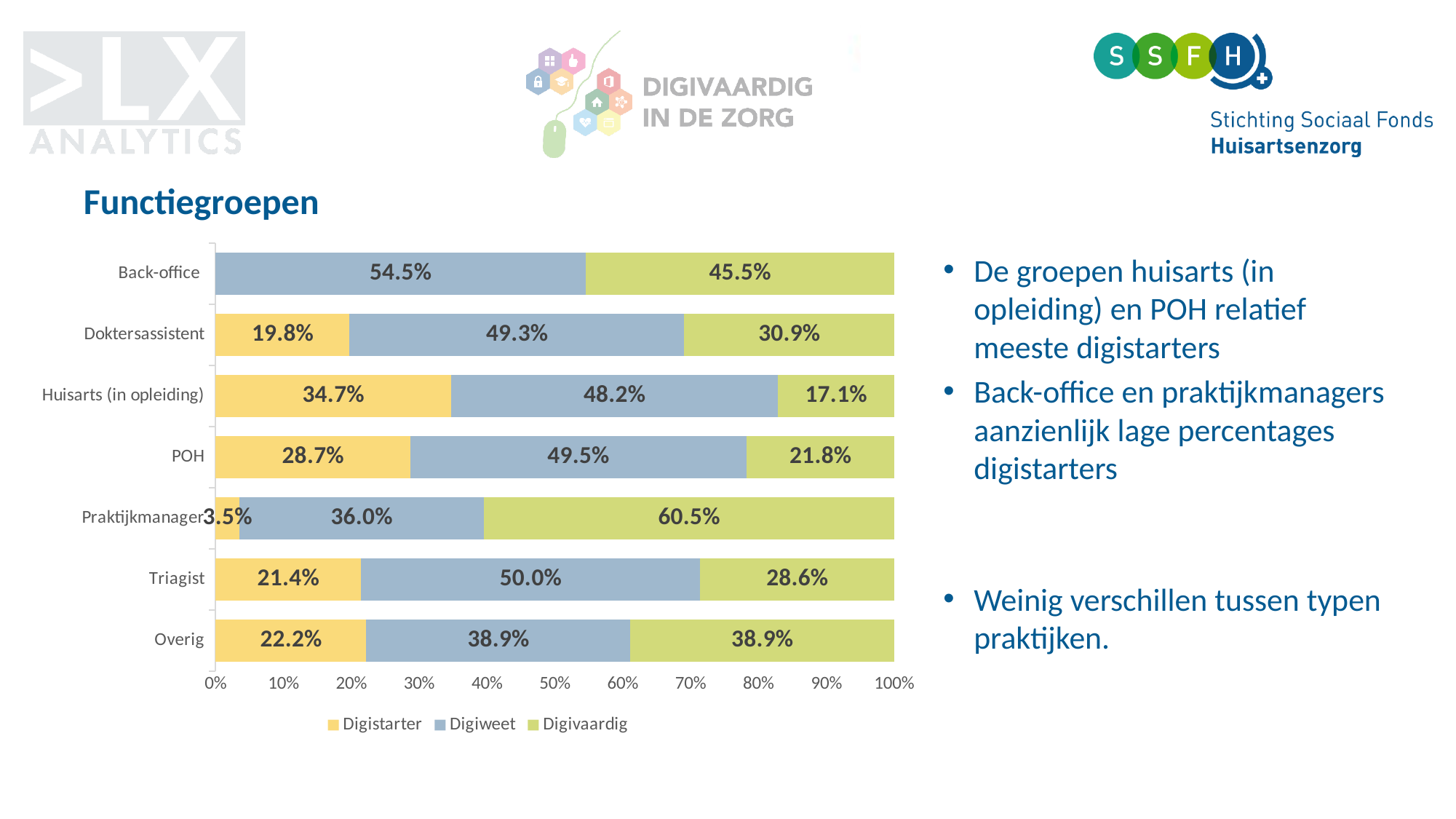
What kind of chart is shown on the slide? Stacked bar chart Which is larger: the Digistarter value for Doktersassistent or for Triagist? Triagist What is the Digiweet value for Back-office? 54.5% How many function groups (categories) are shown in the chart? 7 What is the total of the stacked bar for Overig? 100.0% How many series does the legend list? 3 Which category has the highest Digistarter value? Huisarts (in opleiding) What is the difference between the Digivaardig and Digiweet values for Praktijkmanager? 24.5 percentage points What is the Digistarter value for Huisarts (in opleiding)? 34.7% What is the Digivaardig value for POH? 21.8% Which category has the lowest Digivaardig value? Huisarts (in opleiding) Which category has the highest Digivaardig value? Praktijkmanager